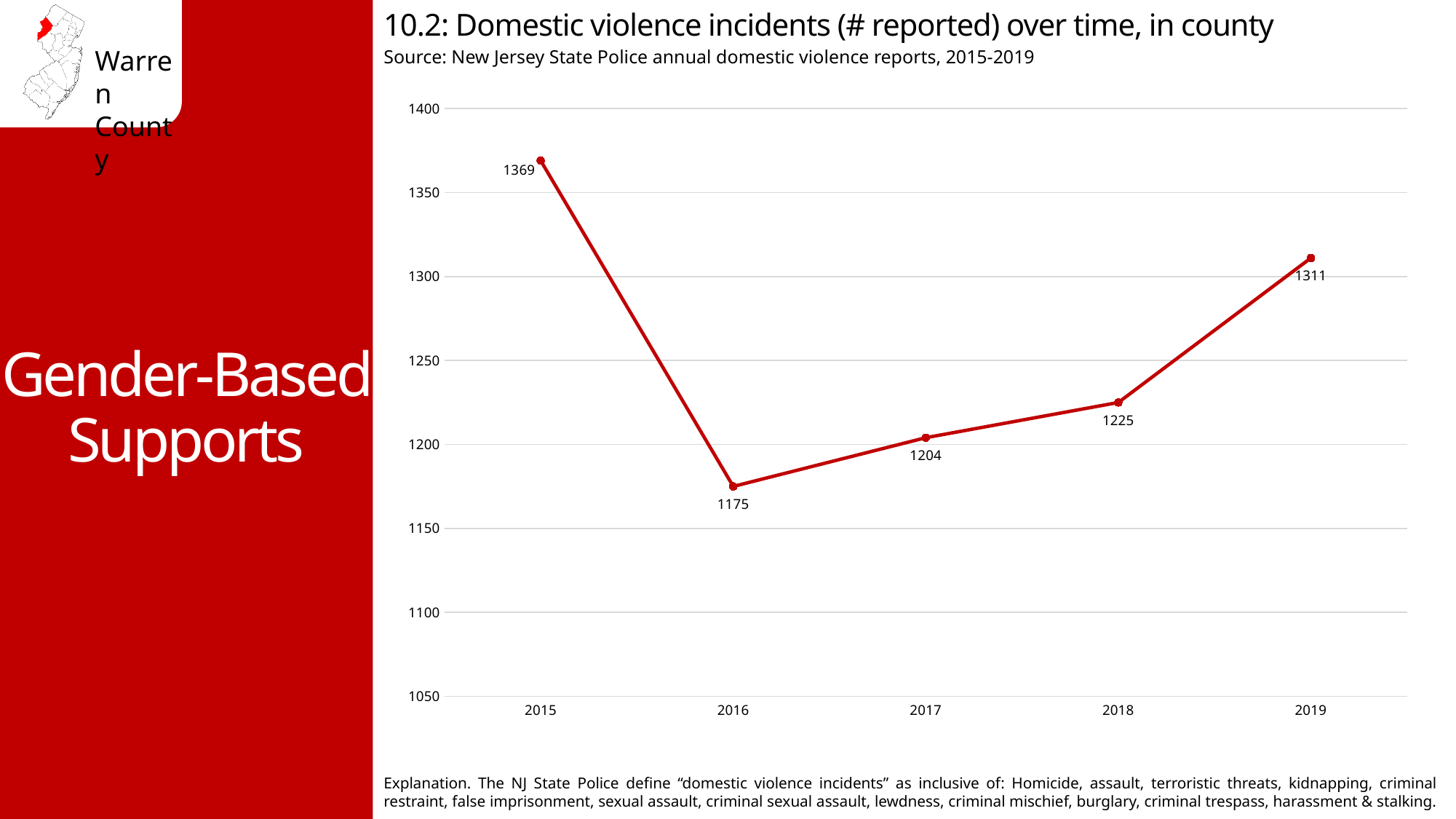
What is the difference in reported incidents between 2015 and 2016? 194 What is the difference in reported incidents between 2019 and 2018? 86 Which year had the lowest number of reported domestic violence incidents? 2016 How many reported domestic violence incidents were there in 2017? 1204 Did the number of reported incidents rise or fall from 2016 to 2019? rise Is the value for 2016 greater or less than 1200? less Which year had more reported incidents, 2017 or 2018? 2018 Which year had the highest number of reported domestic violence incidents? 2015 How many reported domestic violence incidents were there in 2015? 1369 How many reported domestic violence incidents were there in 2019? 1311 How many years are plotted on the chart? 5 What type of chart is shown on the slide? line chart